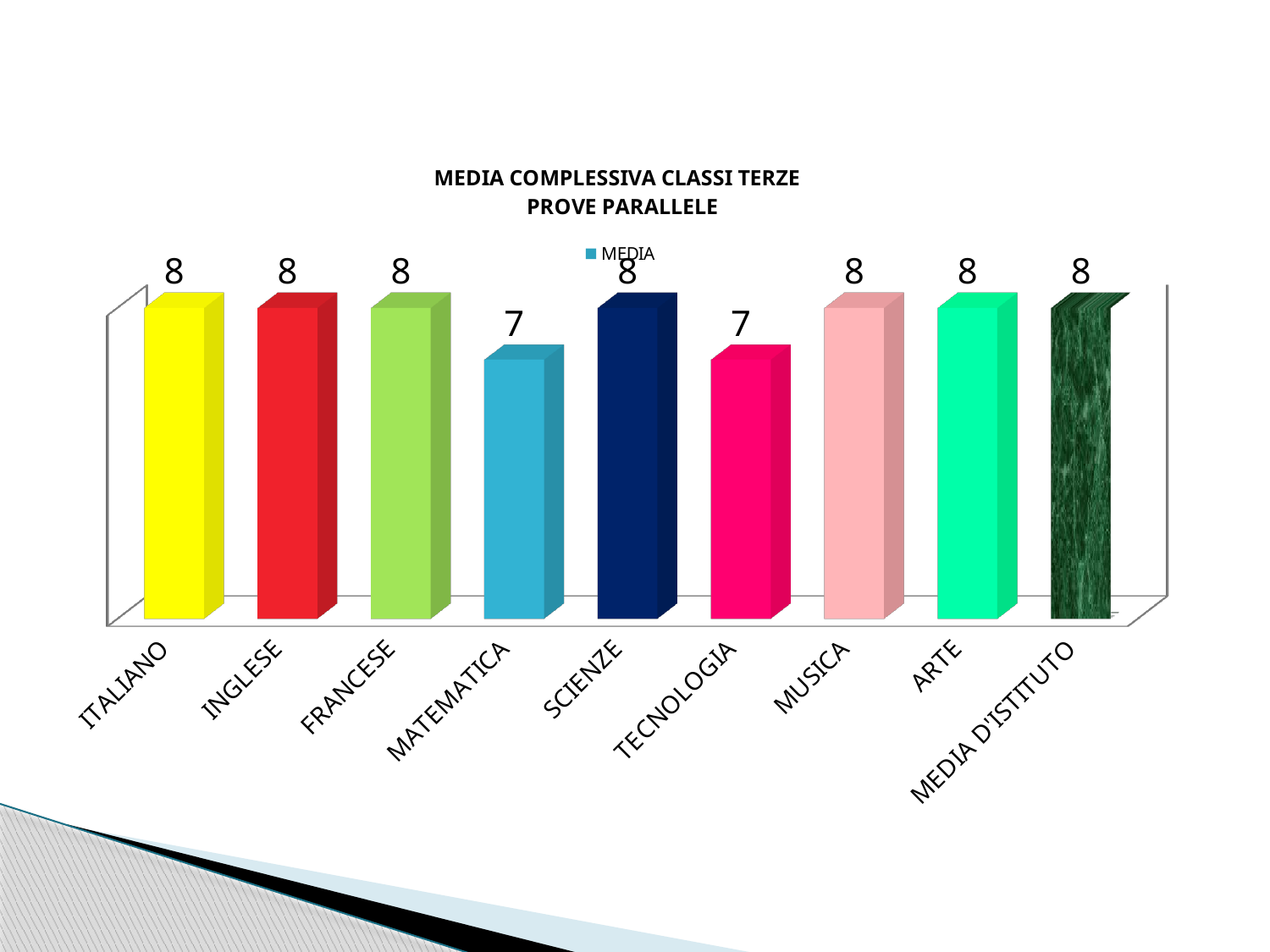
What is the value for ITALIANO? 8 What kind of chart is shown on the slide? bar chart What is the value for SCIENZE? 8 Which is larger, the value for ARTE or the value for TECNOLOGIA? ARTE What is the title of the chart? MEDIA COMPLESSIVA CLASSI TERZE PROVE PARALLELE What is the value for MATEMATICA? 7 How many categories are shown on the x axis? 9 What is the value for MEDIA D'ISTITUTO? 8 What is the difference between the values for ITALIANO and MATEMATICA? 1 Which categories have the lowest value? MATEMATICA and TECNOLOGIA How many series does the legend list? 1 What is the value for TECNOLOGIA? 7